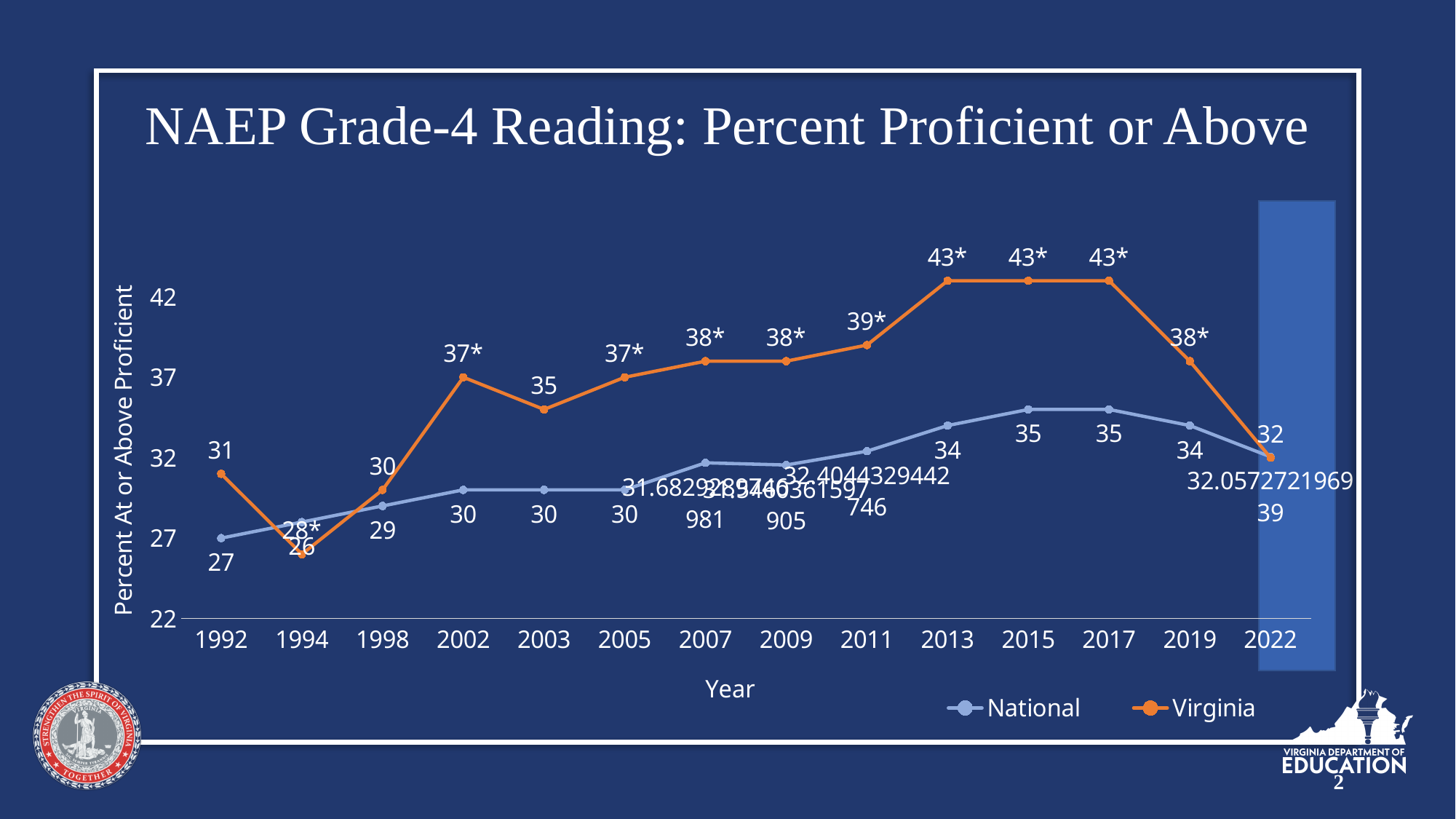
Is the National value for 2007 greater or less than 27? greater How many years are plotted along the x axis? 14 By how many points did the Virginia value fall from 2017 to 2022? 11 What is the National value for 2015? 35 What is the Virginia value for 2022? 32 What type of chart is shown on the slide? line chart How many series does the legend list? 2 What is the Virginia value for 2013? 43* What is the National value for 1992? 27 In 2002, which series has the higher value, National or Virginia? Virginia In which year is the National value lowest? 1992 In which year is the Virginia value lowest? 1994